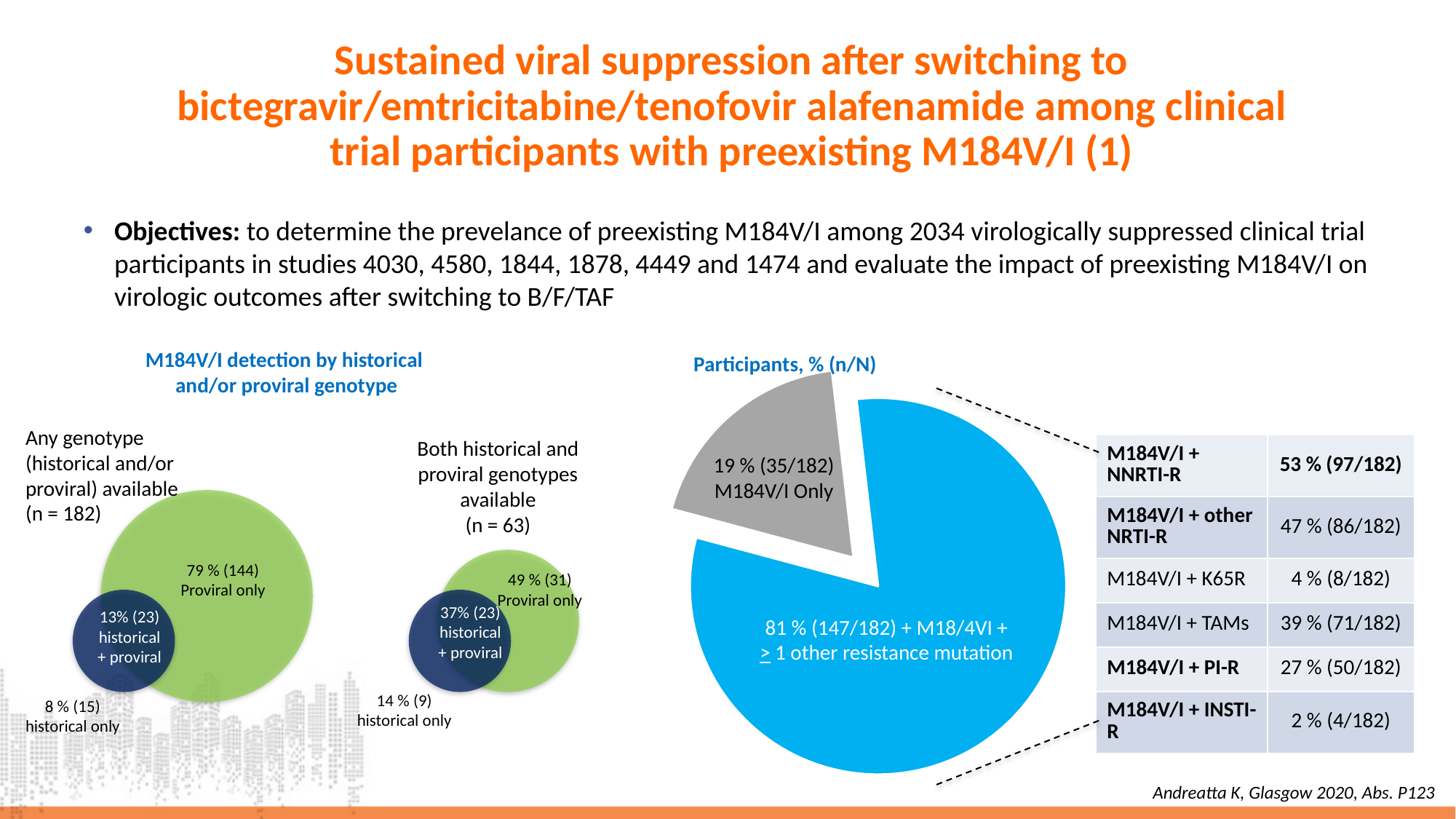
What kind of chart is the 'Participants, % (n/N)' chart? pie chart In the 'Participants, % (n/N)' pie chart, what is the difference in percentage points between the M184V/I + ≥1 other resistance mutation slice and the M184V/I Only slice? 62 percentage points In the 'Participants, % (n/N)' pie chart, how many participants (n/N) had M184V/I plus at least one other resistance mutation? 147/182 In the 'Participants, % (n/N)' pie chart, what percentage of participants had M184V/I plus at least one other resistance mutation? 81 % In the 'Participants, % (n/N)' pie chart, which slice is the largest? M184V/I + ≥ 1 other resistance mutation In the 'M184V/I detection by historical and/or proviral genotype' diagram for any genotype available (n = 182), what percentage was detected by proviral genotype only? 79 % (144) In the 'Participants, % (n/N)' pie chart, how many slices are there? 2 In the 'M184V/I detection by historical and/or proviral genotype' diagram for both historical and proviral genotypes available (n = 63), what percentage was detected by historical genotype only? 14 % (9) In the 'Participants, % (n/N)' pie chart, what percentage of participants had M184V/I only? 19 % In the 'Participants, % (n/N)' pie chart, what colour is the M184V/I Only slice? grey In the 'Participants, % (n/N)' pie chart, how many participants (n/N) had M184V/I only? 35/182 In the 'Participants, % (n/N)' pie chart, which slice is the smallest? M184V/I Only